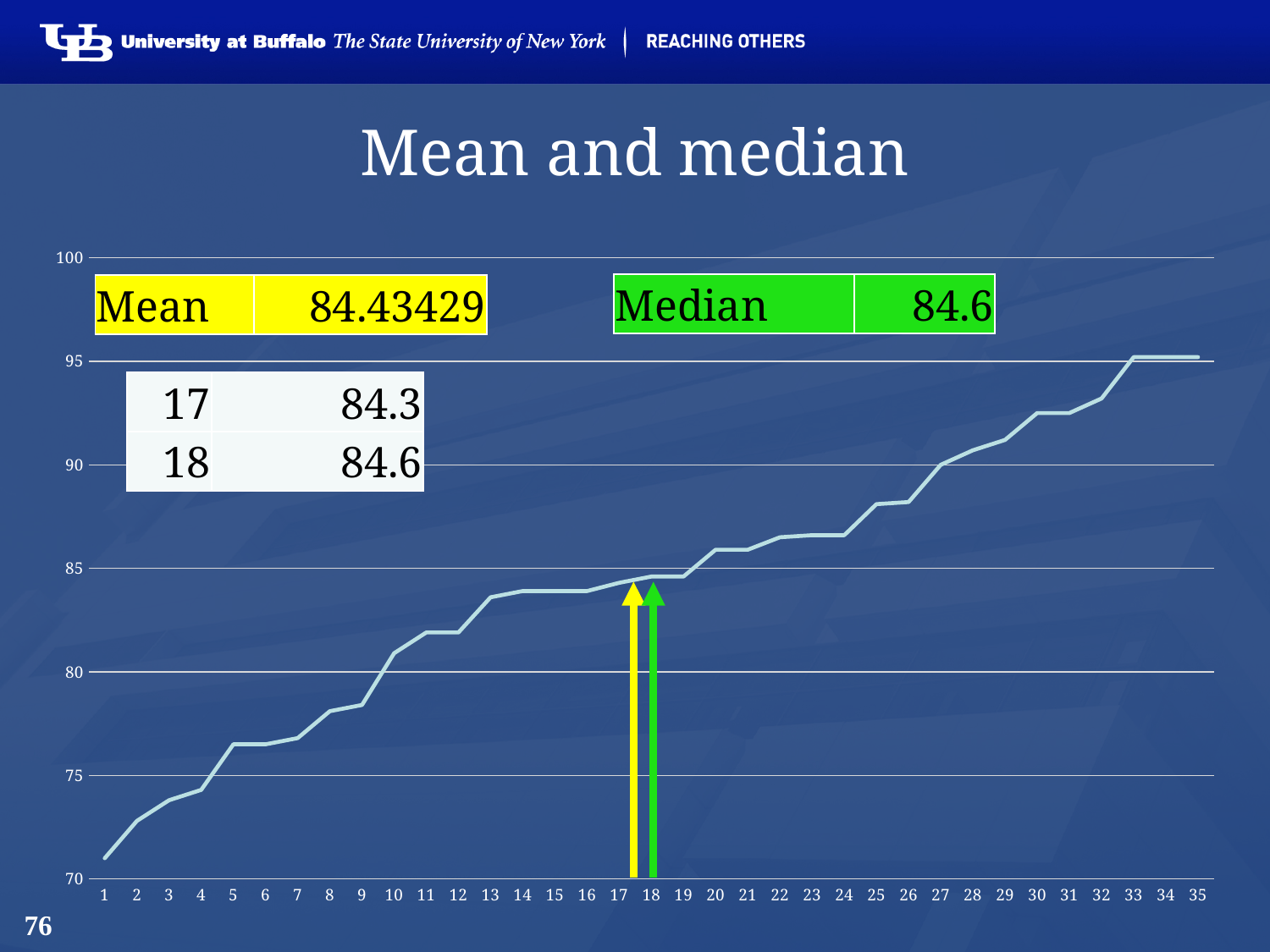
What is the median value shown on the slide? 84.6 What is the mean value shown on the slide? 84.43429 Do the values rise or fall as you move from left to right along the x axis? rise Is the value for point 1 greater or less than 75? less How many points are plotted along the x axis? 35 Which point has the lowest value on the chart? 1 What kind of chart is shown on the slide? line chart What is the difference between the values listed for points 18 and 17? 0.3 Which is larger, the mean or the median? median What value is listed for point 17 in the table on the chart? 84.3 Is the value for point 30 greater or less than 90? greater What value is listed for point 18 in the table on the chart? 84.6